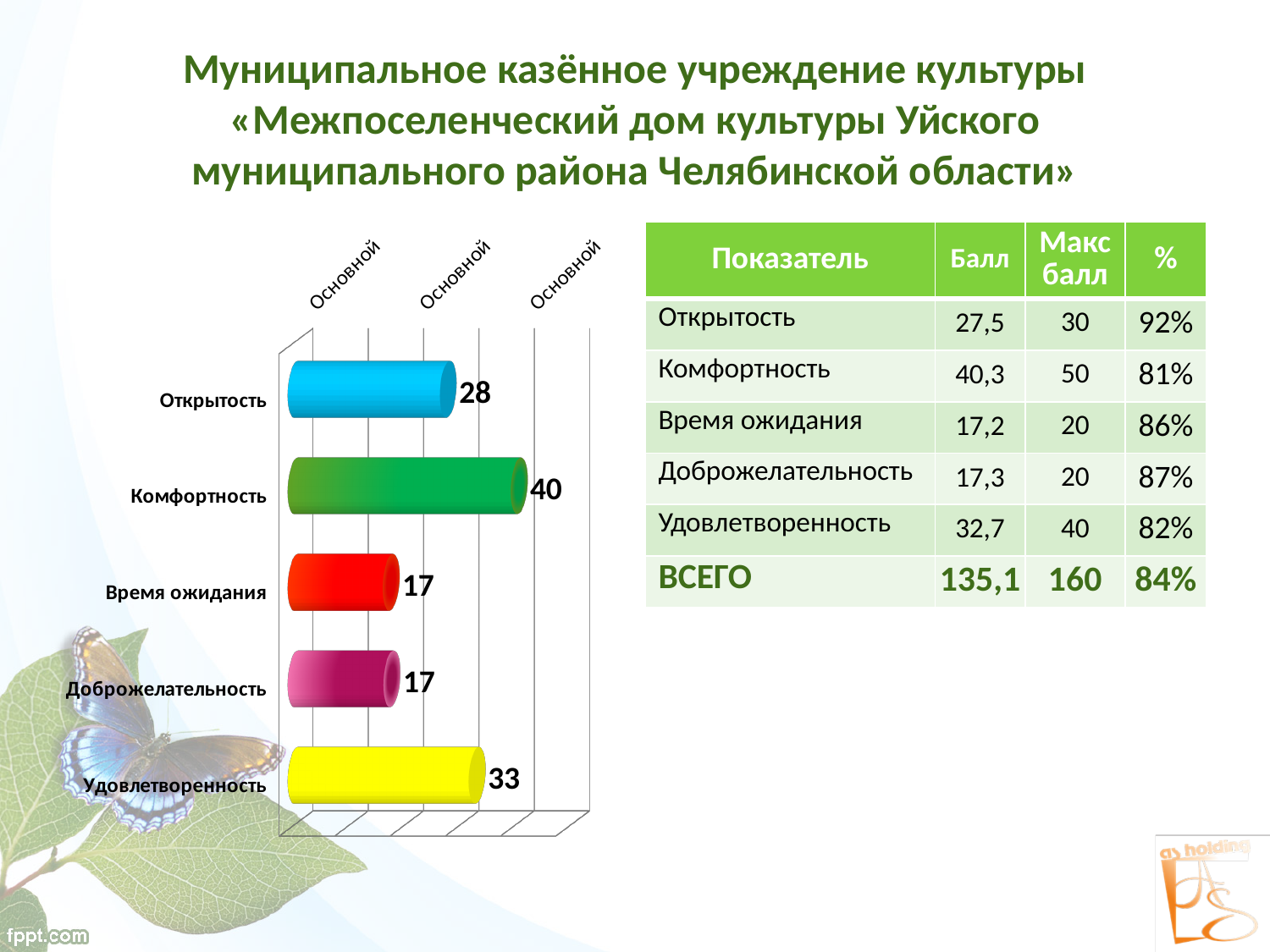
What is the difference between the values for Удовлетворенность and Доброжелательность on the chart? 16 Do Время ожидания and Доброжелательность have the same value on the chart? Yes What value is shown for Время ожидания on the chart? 17 What value is shown for Удовлетворенность on the chart? 33 Which is larger on the chart, the value for Открытость or the value for Удовлетворенность? Удовлетворенность What colour is the bar for Удовлетворенность on the chart? Yellow Which category has the highest value on the chart? Комфортность What is the difference between the values for Комфортность and Открытость on the chart? 12 What kind of chart is shown on the slide? Bar chart How many categories are plotted on the chart? 5 What value is shown for Комфортность on the chart? 40 What value is shown for Открытость on the chart? 28